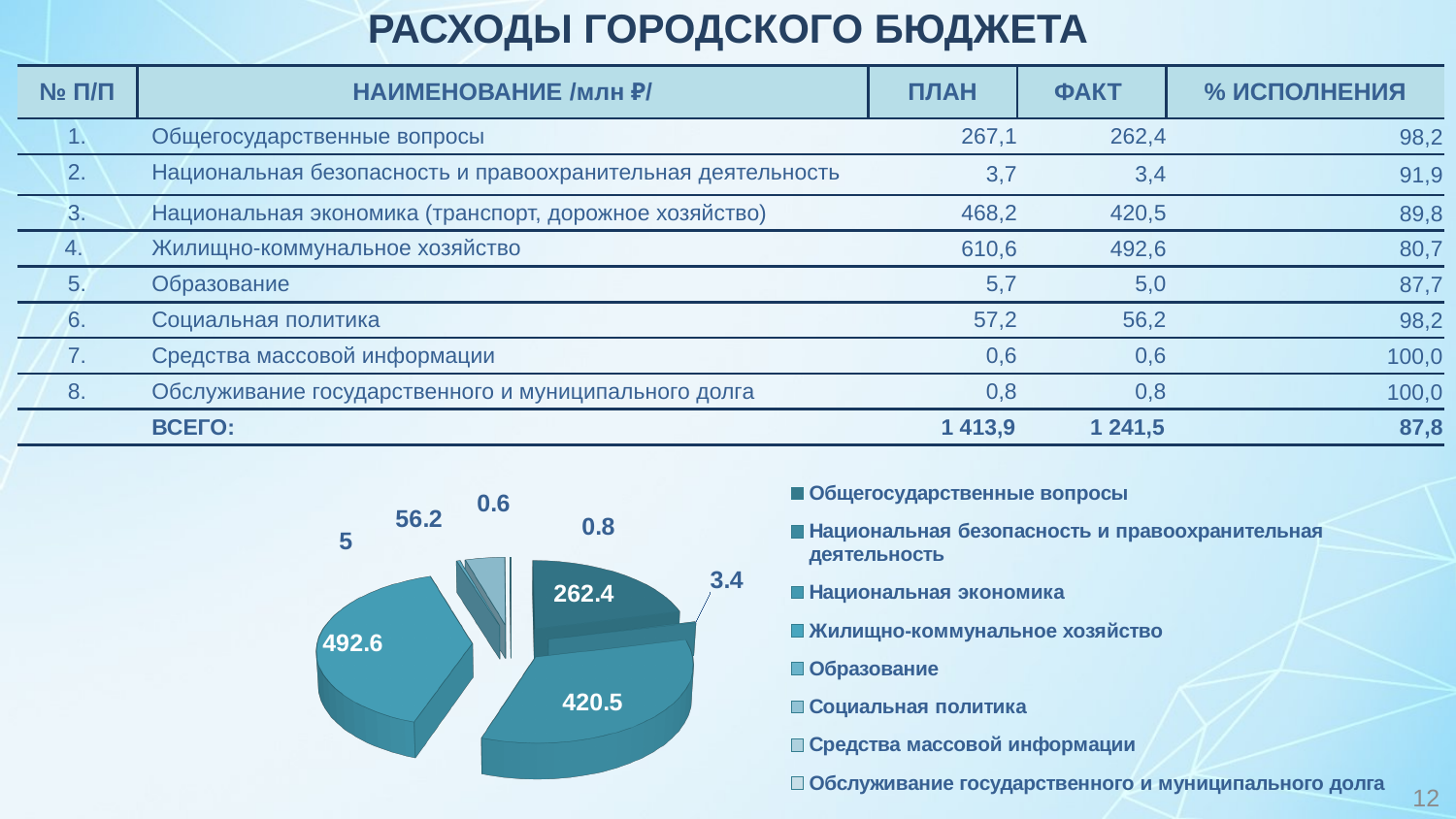
In the pie chart, what is the value for Жилищно-коммунальное хозяйство? 492.6 In the pie chart, what is the difference between the values for Жилищно-коммунальное хозяйство and Национальная экономика? 72.1 In the pie chart, what is the value for Общегосударственные вопросы? 262.4 What type of chart is shown on the slide? pie chart In the pie chart, what is the value for Социальная политика? 56.2 Which category has the largest slice in the pie chart? Жилищно-коммунальное хозяйство How many slices does the pie chart have? 8 In the pie chart, what is the value for Национальная безопасность и правоохранительная деятельность? 3.4 Which category has the smallest slice in the pie chart? Средства массовой информации In the pie chart, what is the value for Национальная экономика? 420.5 How many entries does the pie chart's legend list? 8 In the pie chart, which is larger: Национальная экономика or Общегосударственные вопросы? Национальная экономика